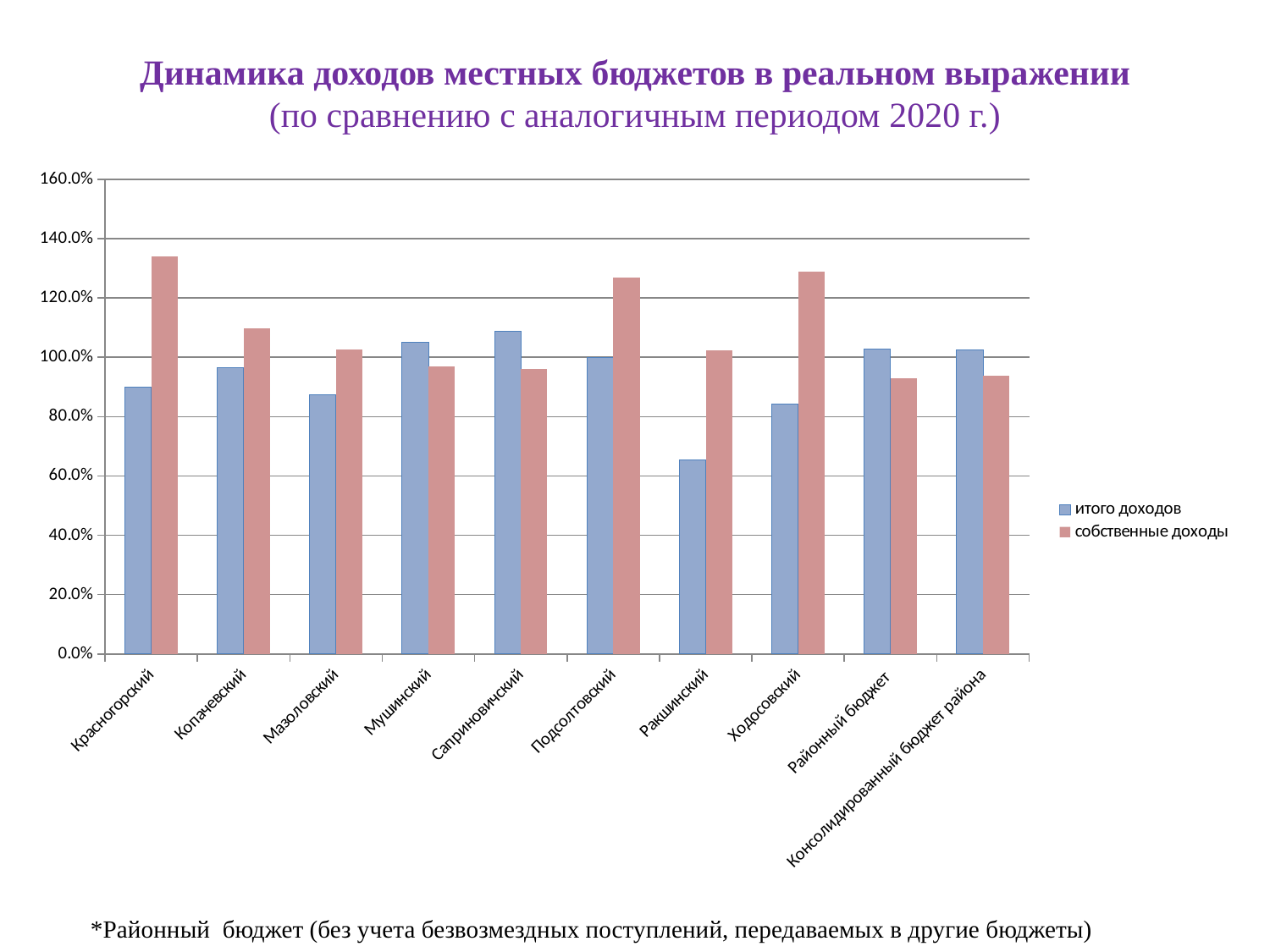
Which series is shown in blue in the legend? итого доходов How many categories are shown on the x axis? 10 Is the value for итого доходов for Ракшинский greater or less than 80.0%? less Is the value for собственные доходы for Ходосовский greater or less than 120.0%? greater What kind of chart is shown on the slide? bar chart How many series does the legend list? 2 Is the value for итого доходов for Мазоловский greater or less than 100.0%? less What is the highest value shown on the y axis? 160.0% For Красногорский, which is larger: итого доходов or собственные доходы? собственные доходы Which category has the lowest value for итого доходов? Ракшинский For Саприновичский, which is larger: итого доходов or собственные доходы? итого доходов